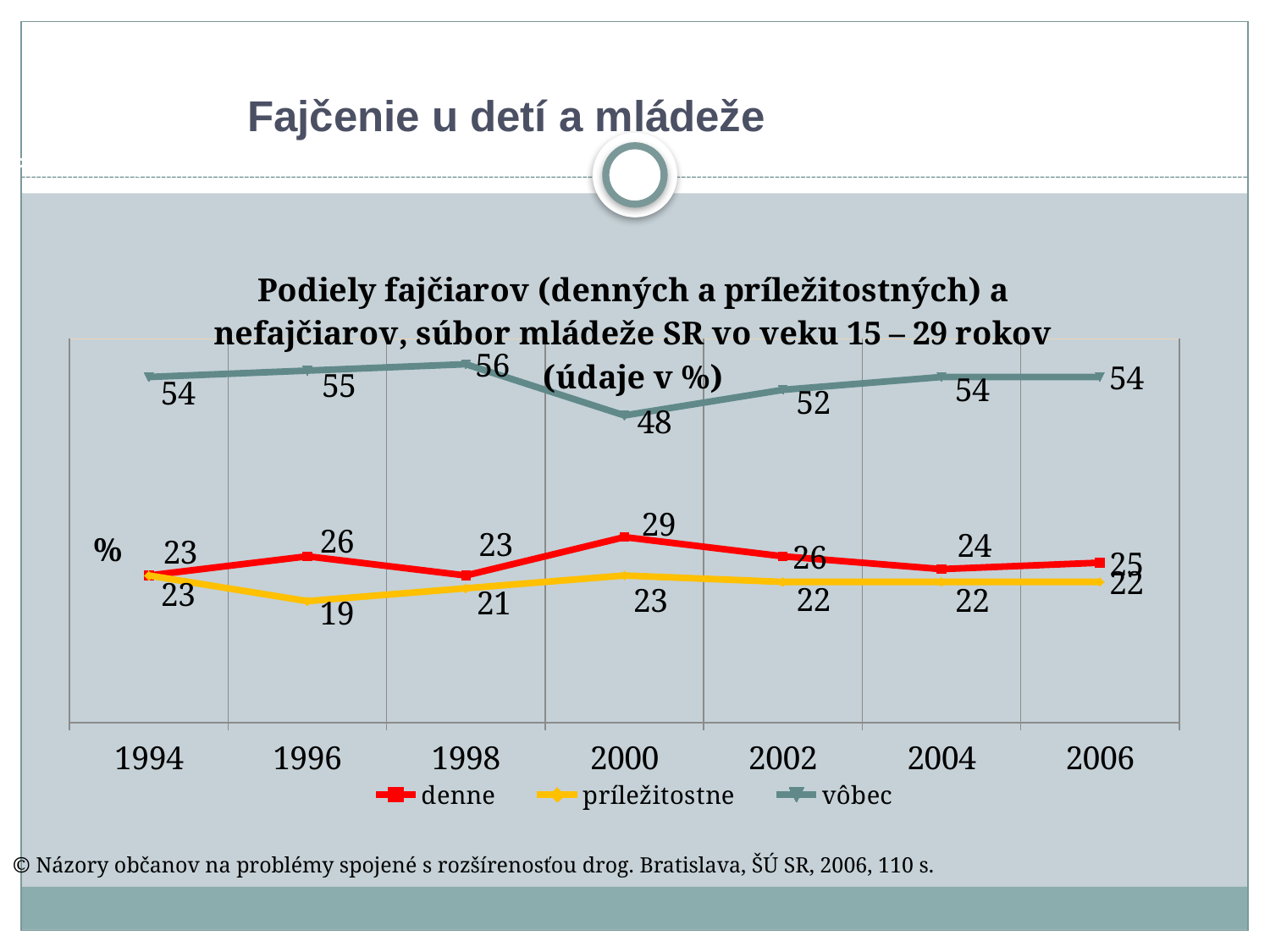
What is the value for 'vôbec' in 1998? 56 What is the difference between the 'vôbec' value in 1998 and in 2000? 8 What kind of chart is shown on the slide? line chart In which year is the 'vôbec' series at its lowest? 2000 How many years are plotted along the x axis? 7 What is the value for 'denne' in 2000? 29 In which year is the 'denne' series at its highest? 2000 How many series does the legend list? 3 Which series is drawn in red? denne Does the 'vôbec' series rise or fall from 2000 to 2004? rise What is the value for 'príležitostne' in 1996? 19 Which is larger in 2006, the value for 'denne' or for 'príležitostne'? denne